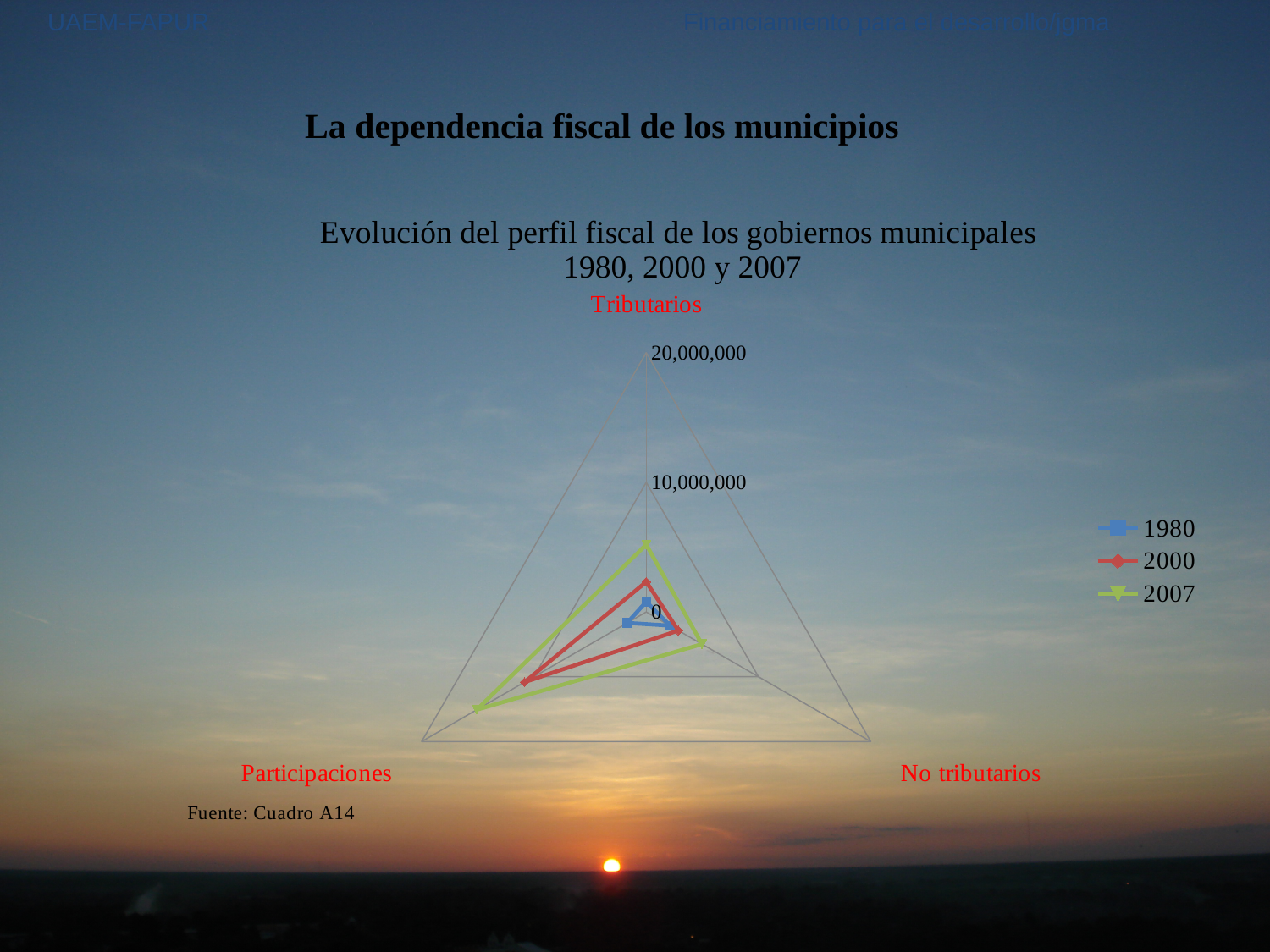
For the 2007 series, which is larger: Participaciones or Tributarios? Participaciones How many axes (categories) does the radar chart have? 3 How many series does the chart legend list? 3 Which series has the highest value for Participaciones? 2007 Is the 2007 value for No tributarios greater or less than 10,000,000? less What is the highest value shown on the chart's axis scale? 20,000,000 Which series has the lowest values on all three axes? 1980 Is the 2007 value for Participaciones greater or less than 10,000,000? greater Is the 1980 value for Participaciones greater or less than 10,000,000? less What kind of chart is shown on the slide? Radar chart Which years are listed in the chart legend? 1980, 2000, 2007